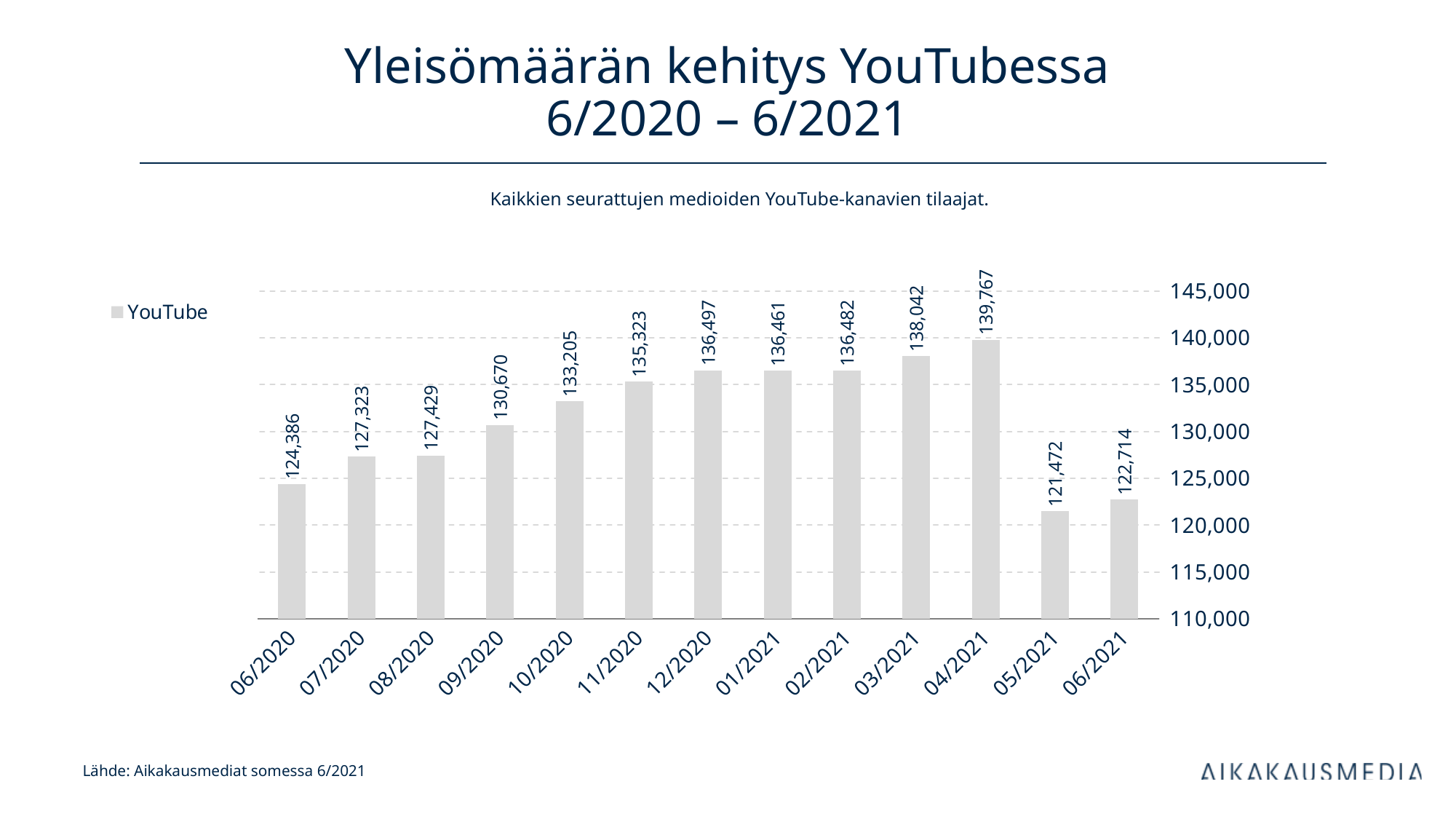
What kind of chart is shown on the slide? bar chart Which month has the lowest value? 05/2021 Is the value for 09/2020 greater or less than 130,000? greater What is the value for 05/2021? 121,472 What is the value for 04/2021? 139,767 How many months are shown on the x axis? 13 Which is larger, the value for 10/2020 or the value for 03/2021? 03/2021 What is the difference between the values for 06/2021 and 06/2020? 1,672 What is the difference between the values for 04/2021 and 05/2021? 18,295 What is the value for 06/2020? 124,386 Which month has the highest value? 04/2021 What series name does the legend show? YouTube